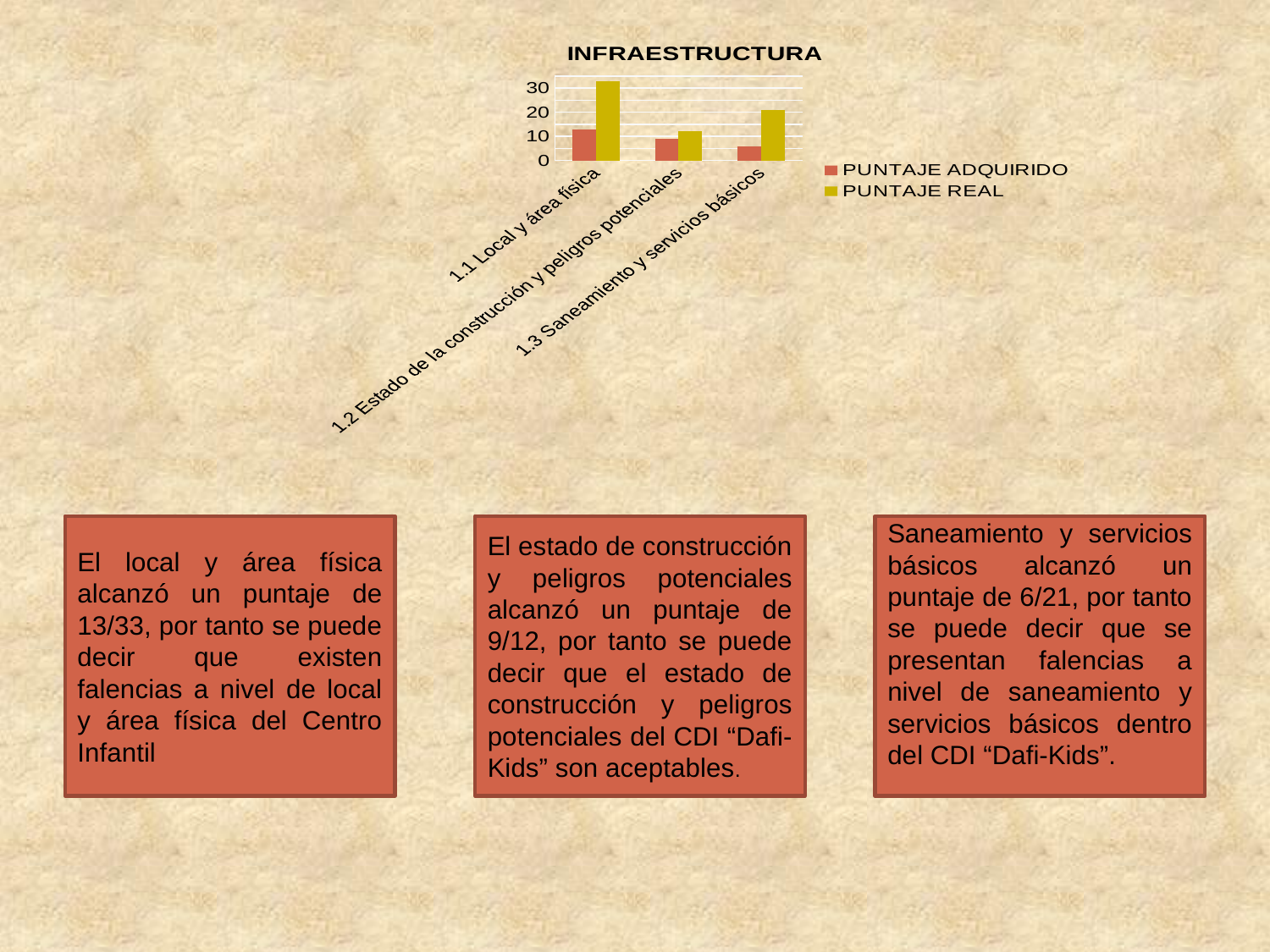
Is the PUNTAJE REAL value for 1.1 Local y área física greater or less than 20? greater What is the title of the chart? INFRAESTRUCTURA Which series is shown in yellow in the chart? PUNTAJE REAL Which category has the highest PUNTAJE REAL value? 1.1 Local y área física Is the PUNTAJE ADQUIRIDO value for 1.1 Local y área física greater or less than 20? less Which is larger, the PUNTAJE ADQUIRIDO for 1.1 Local y área física or for 1.2 Estado de la construcción y peligros potenciales? 1.1 Local y área física Which category has the lowest PUNTAJE ADQUIRIDO value? 1.3 Saneamiento y servicios básicos How many categories are shown on the x axis of the chart? 3 What kind of chart is shown on the slide? bar chart Is the PUNTAJE REAL value for 1.3 Saneamiento y servicios básicos greater or less than 10? greater Which is larger, the PUNTAJE REAL for 1.2 Estado de la construcción y peligros potenciales or for 1.3 Saneamiento y servicios básicos? 1.3 Saneamiento y servicios básicos How many series does the chart legend list? 2